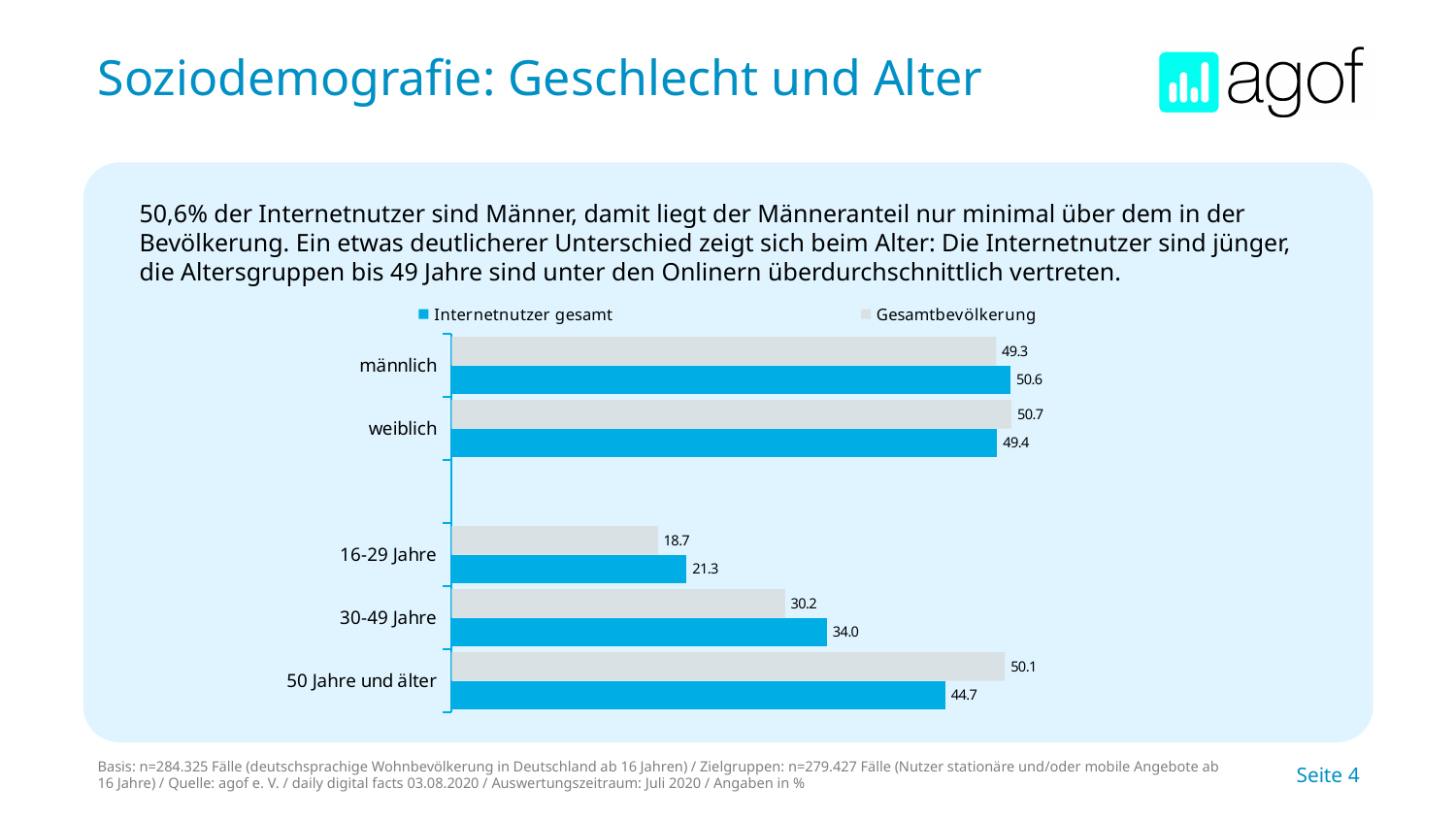
What is the value for Gesamtbevölkerung in the 30-49 Jahre category? 30.2 What kind of chart is shown on the slide? Bar chart What is the difference between Internetnutzer gesamt and Gesamtbevölkerung in the 30-49 Jahre category? 3.8 What is the value for Gesamtbevölkerung in the 50 Jahre und älter category? 50.1 In the 16-29 Jahre category, which series has the larger value, Internetnutzer gesamt or Gesamtbevölkerung? Internetnutzer gesamt What is the value for Internetnutzer gesamt in the 16-29 Jahre category? 21.3 Which age group has the highest value for Gesamtbevölkerung? 50 Jahre und älter How many series does the legend list? 2 How many categories are shown on the chart? 5 What is the difference between Gesamtbevölkerung and Internetnutzer gesamt in the 50 Jahre und älter category? 5.4 What is the value for Internetnutzer gesamt in the männlich category? 50.6 Which age group has the lowest value for Internetnutzer gesamt? 16-29 Jahre